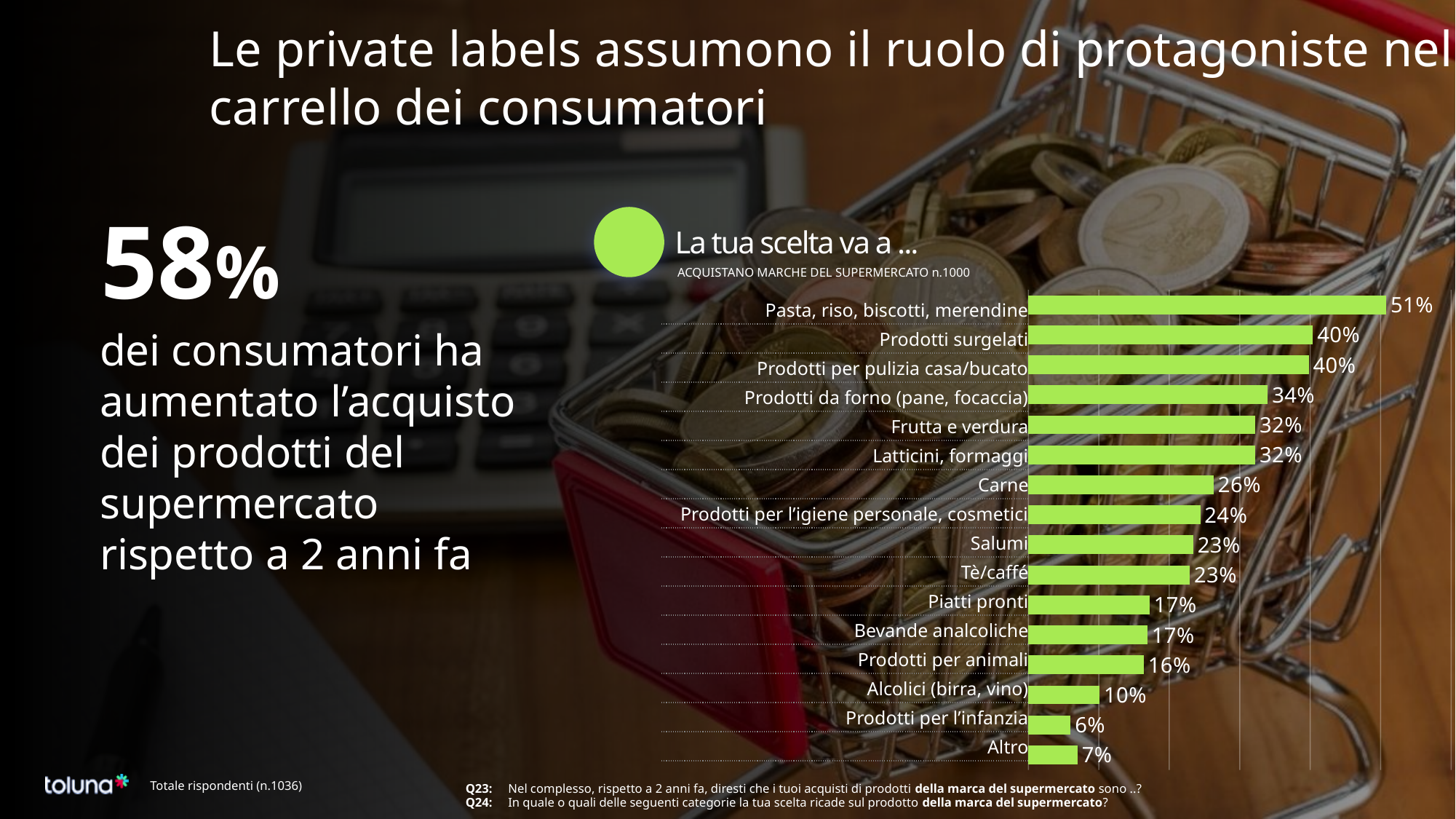
What kind of chart is shown on the slide? Bar chart Which category has the highest value? Pasta, riso, biscotti, merendine What is the difference between the values for Pasta, riso, biscotti, merendine and Prodotti surgelati? 11% Which category has the lowest value? Prodotti per l'infanzia What is the value for Prodotti per animali? 16% Which is larger, the value for Prodotti da forno (pane, focaccia) or the value for Frutta e verdura? Prodotti da forno (pane, focaccia) What is the value for Pasta, riso, biscotti, merendine? 51% What is the value for Alcolici (birra, vino)? 10% Which is larger, the value for Altro or the value for Prodotti per l'infanzia? Altro What is the value for Carne? 26% What is the difference between the values for Carne and Salumi? 3% How many categories are shown in the chart? 16